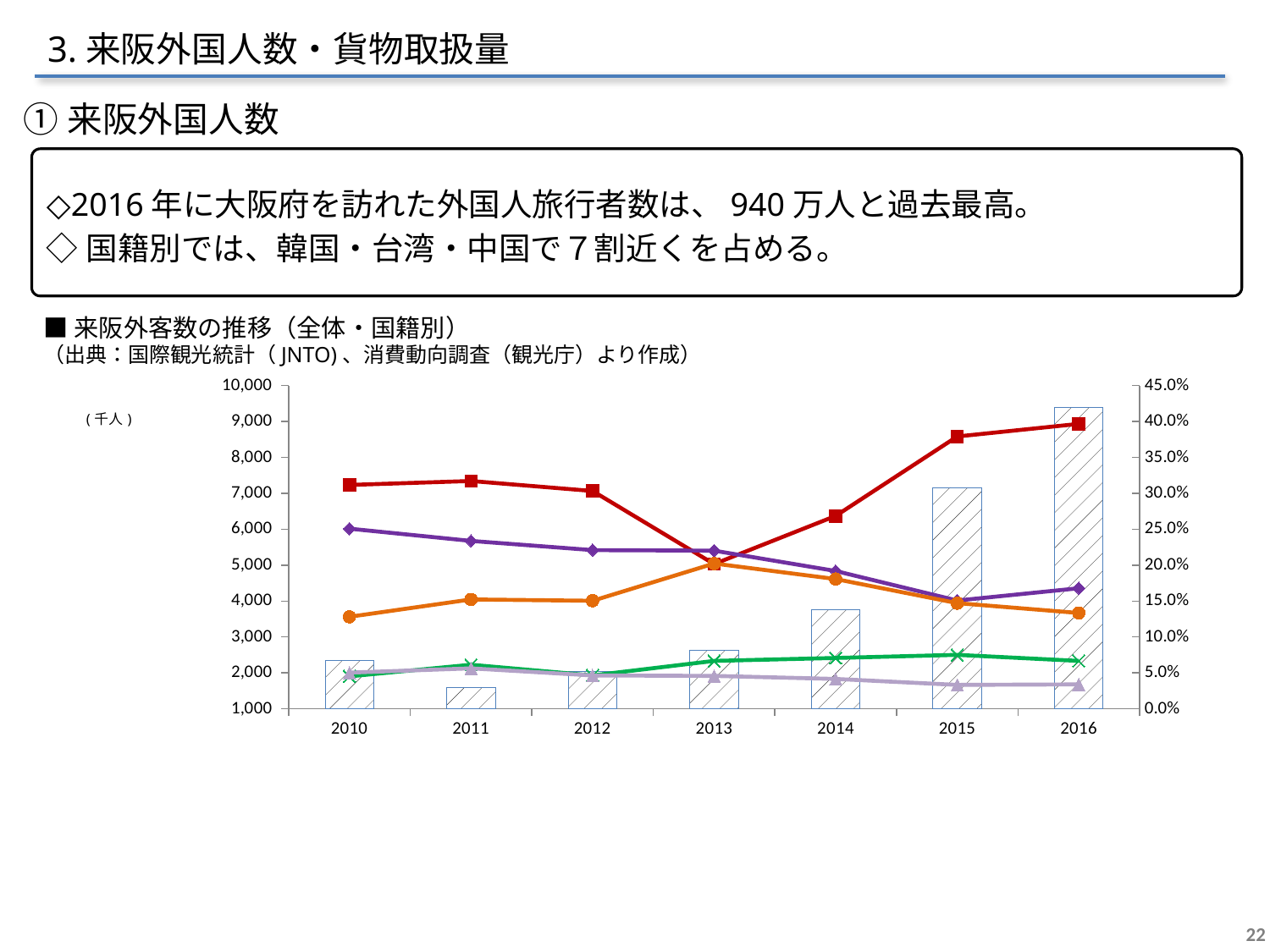
Is the bar value for 2010 greater or less than 2,000? greater What unit is shown for the left axis of the chart? 千人 Is the bar value for 2014 greater or less than 4,000? less How many years are shown along the x axis of the chart? 7 Is the bar value for 2015 greater or less than 6,000? greater What kind of chart is shown on the slide? A combination bar and line chart Which year has the taller bar, 2013 or 2014? 2014 Do the bars rise or fall from 2013 to 2016? rise Which year has the shortest bar in the chart? 2011 Which year has the tallest bar in the chart? 2016